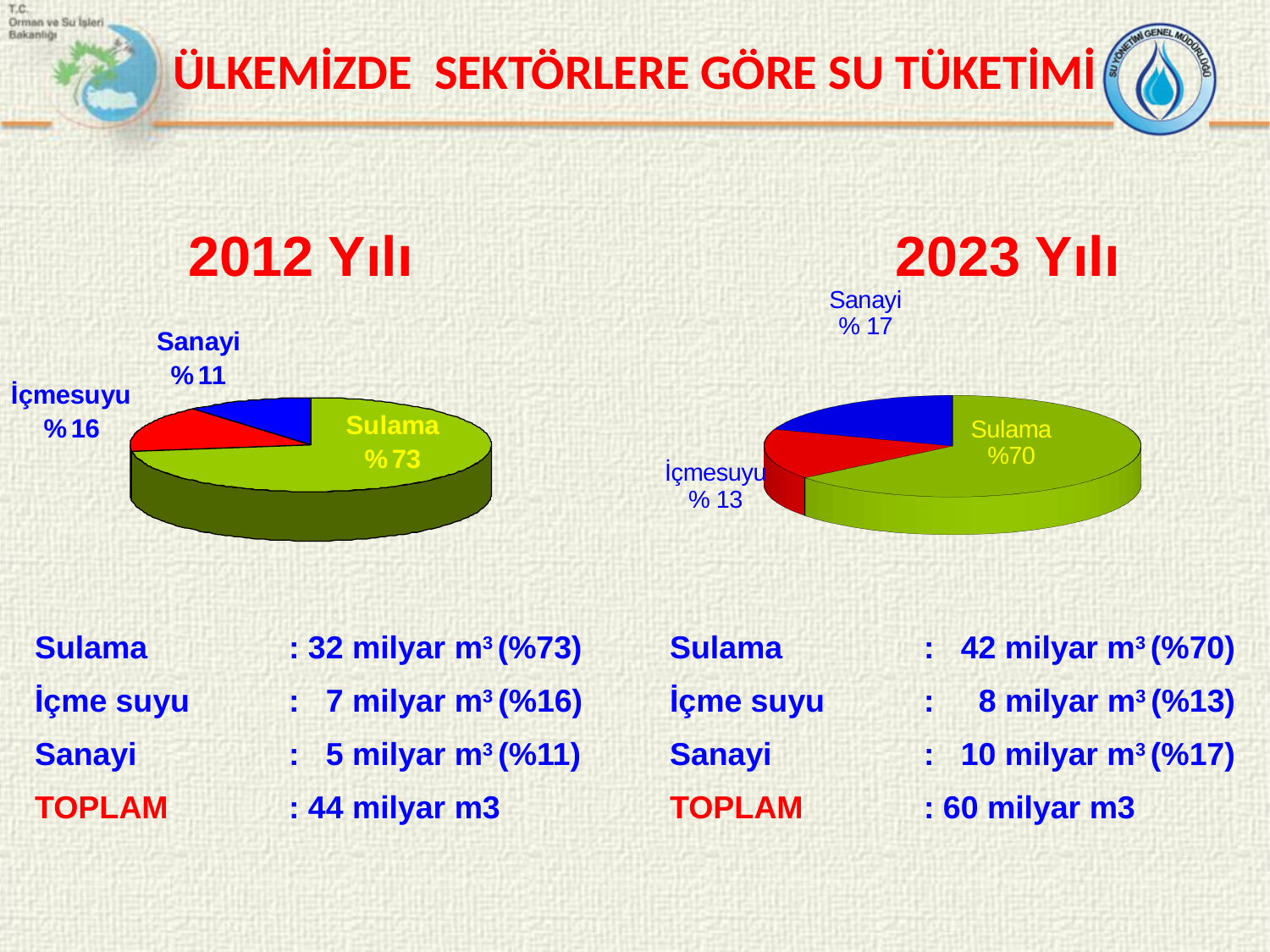
In the 2012 Yılı chart, what share does Sulama have? % 73 In the 2023 Yılı chart, what share does Sulama have? %70 In the 2023 Yılı chart, what share does Sanayi have? % 17 In the 2023 Yılı chart, what colour is the Sulama slice? green In the 2012 Yılı chart, which sector has the smallest slice? Sanayi In the 2023 Yılı chart, which is larger, Sanayi or İçmesuyu? Sanayi In the 2012 Yılı chart, which sector has the largest slice? Sulama How many slices does the 2023 Yılı pie chart have? 3 In the 2012 Yılı chart, what share does İçmesuyu have? % 16 What kind of chart is the 2012 Yılı chart? pie chart In the 2012 Yılı chart, what share does Sanayi have? % 11 In the 2023 Yılı chart, what share does İçmesuyu have? % 13